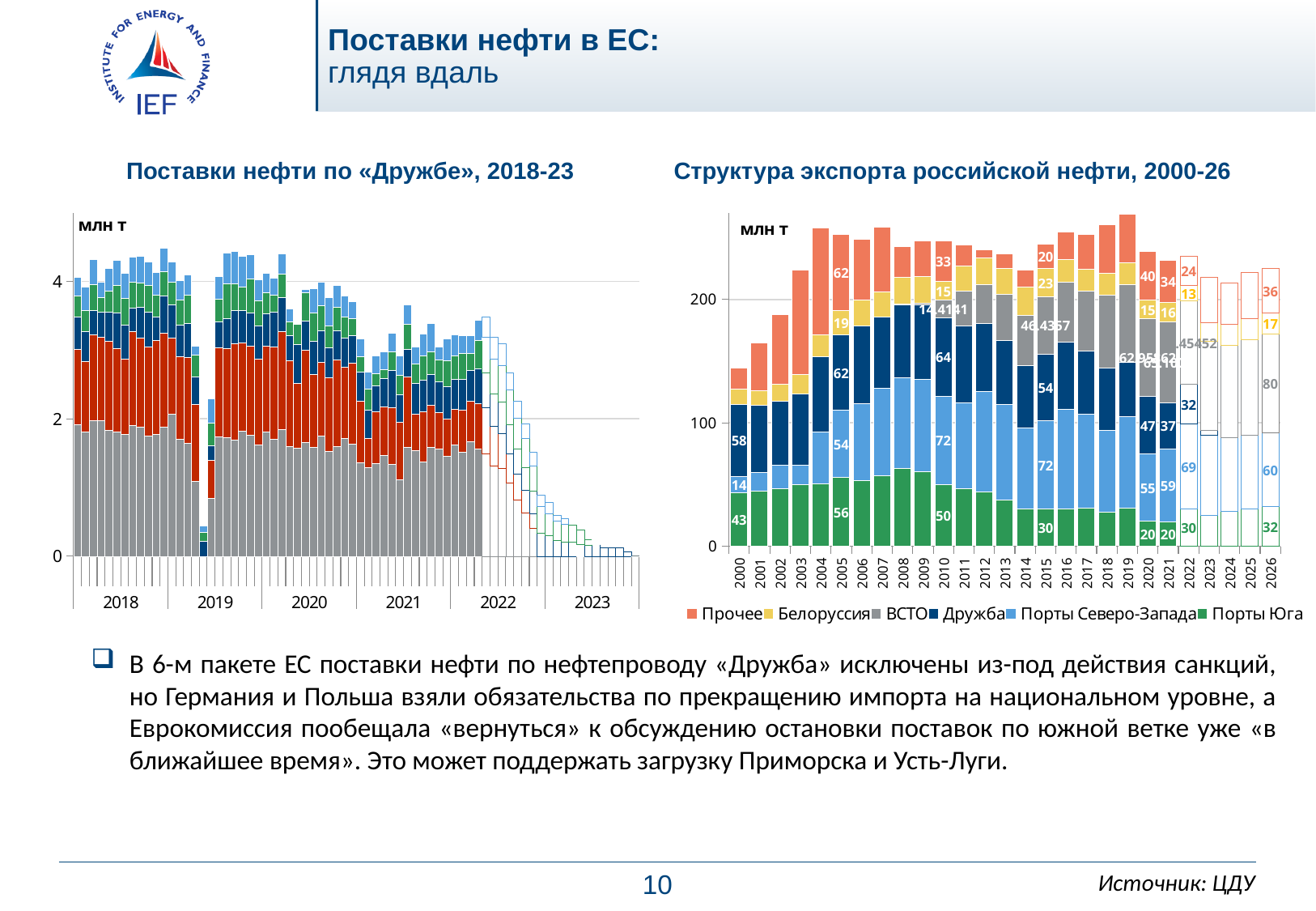
On the chart 'Структура экспорта российской нефти, 2000-26', what is the value for Порты Юга in 2000? 43 What kind of chart is 'Структура экспорта российской нефти, 2000-26'? Stacked bar chart On the chart 'Структура экспорта российской нефти, 2000-26', which is larger in 2010: Порты Северо-Запада or Дружба? Порты Северо-Запада On the chart 'Структура экспорта российской нефти, 2000-26', what is the value for Порты Северо-Запада in 2010? 72 On the chart 'Структура экспорта российской нефти, 2000-26', how many series does the legend list? 6 On the chart 'Структура экспорта российской нефти, 2000-26', what is the value for ВСТО in 2026? 80 On the chart 'Структура экспорта российской нефти, 2000-26', what is the value for Дружба in 2000? 58 On the chart 'Структура экспорта российской нефти, 2000-26', what is the value for Прочее in 2020? 40 On the chart 'Поставки нефти по «Дружбе», 2018-23', how many years are labelled on the x axis? 6 On the chart 'Поставки нефти по «Дружбе», 2018-23', what unit is shown on the y axis? млн т On the chart 'Поставки нефти по «Дружбе», 2018-23', do the values rise or fall from 2022 into 2023? Fall On the chart 'Структура экспорта российской нефти, 2000-26', what is the difference between the Дружба values for 2020 and 2021? 10